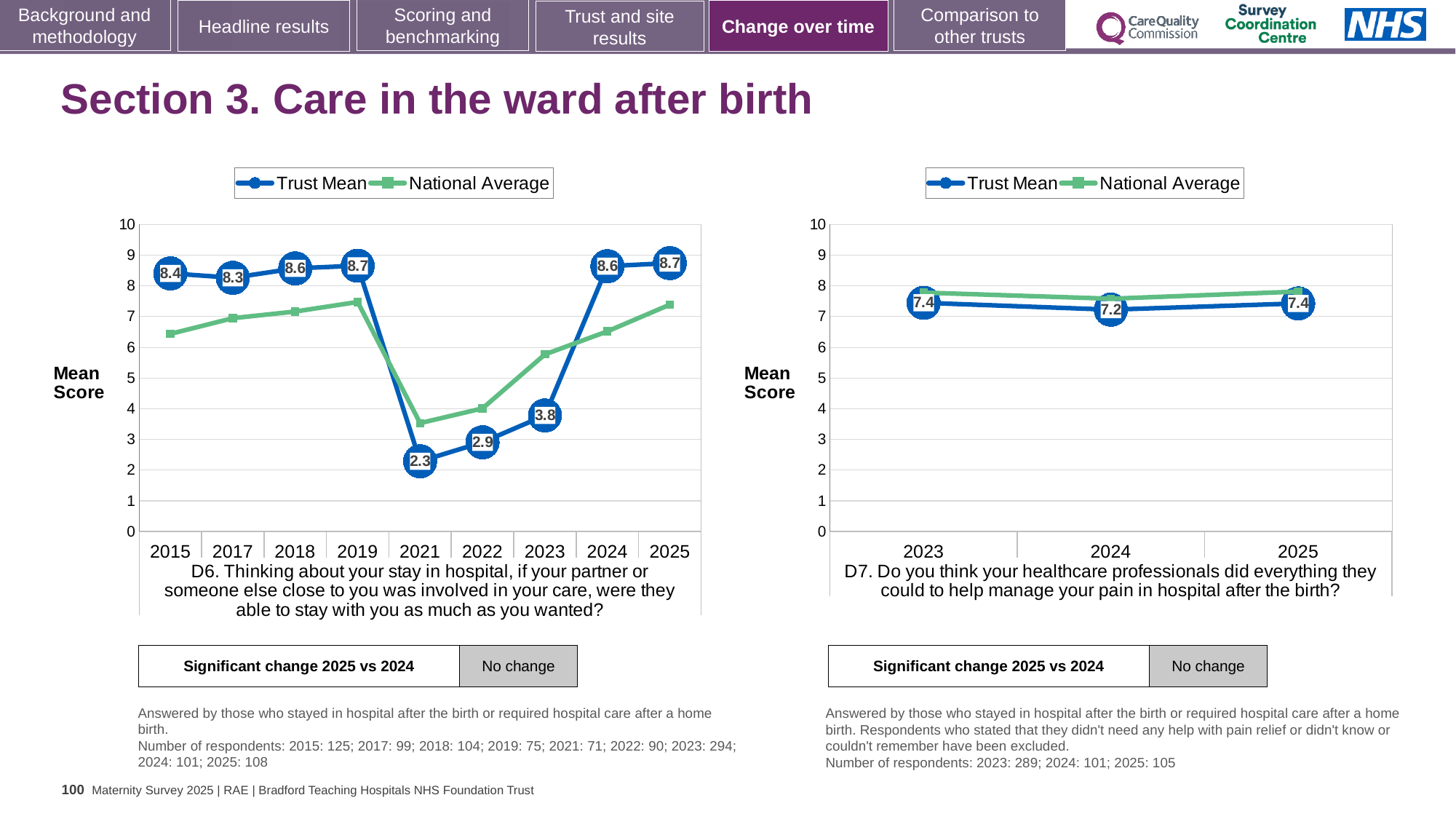
On the right chart (D7), how many series does the legend list? 2 What type of chart is used for the D7 question on the right? Line chart On the right chart (D7), which year has the lowest Trust Mean score? 2024 On the right chart (D7), what is the difference between the Trust Mean scores for 2025 and 2024? 0.2 On the left chart (D6), what is the difference between the Trust Mean scores for 2019 and 2021? 6.4 On the left chart (D6), what is the Trust Mean score for 2015? 8.4 On the left chart (D6), what is the Trust Mean score for 2021? 2.3 On the left chart (D6), is the National Average value for 2021 greater or less than 4? less On the left chart (D6), how many years are plotted on the x axis? 9 On the left chart (D6), which year has the lowest Trust Mean score? 2021 On the right chart (D7), what is the Trust Mean score for 2024? 7.2 On the left chart (D6), in 2023, which is higher: the Trust Mean or the National Average? National Average